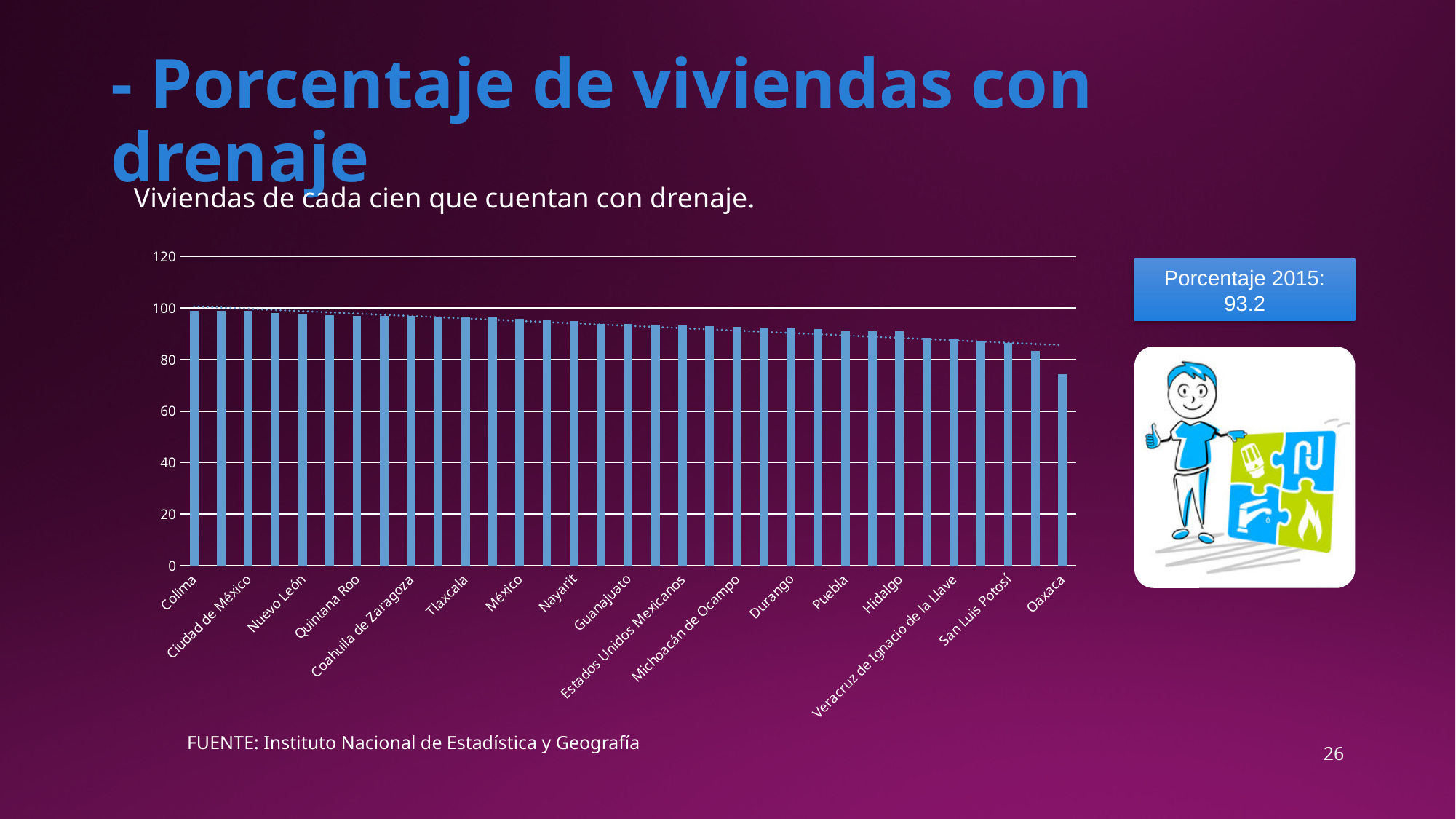
What kind of chart is shown on the slide? bar chart Is the value for Oaxaca greater or less than 80? less Is the value for Hidalgo greater or less than 80? greater Which has a larger value, Colima or Oaxaca? Colima Is the value for Colima greater or less than 80? greater Which category has the lowest value in the chart? Oaxaca Which has a larger value, Oaxaca or Durango? Durango What is the 2015 percentage shown in the box to the right of the chart? 93.2 Which has a larger value, Tlaxcala or San Luis Potosí? Tlaxcala Do the values rise or fall moving from left to right along the x axis? fall What source is cited below the chart? Instituto Nacional de Estadística y Geografía